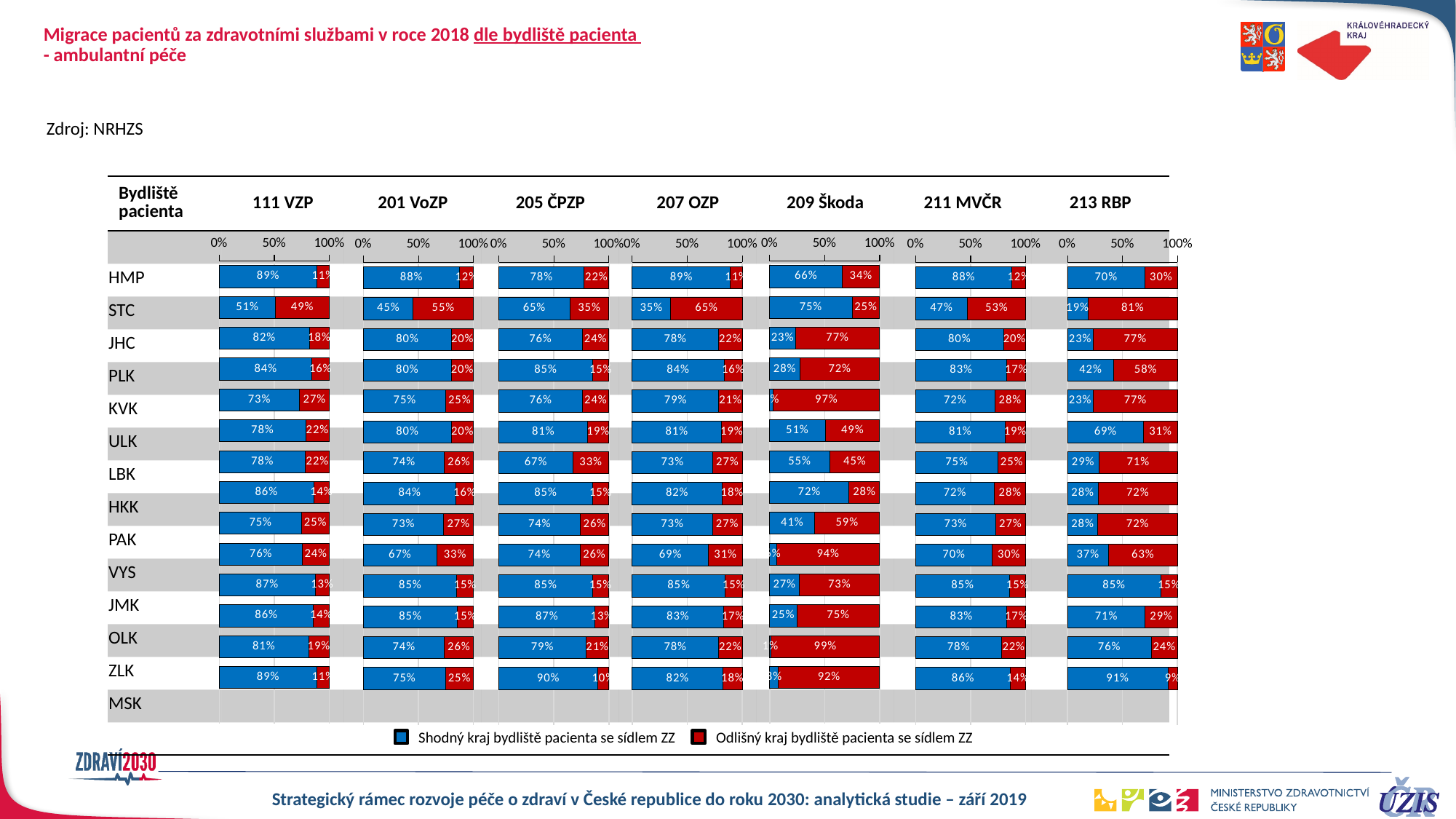
In the 111 VZP chart, what is the blue (Shodný kraj) share for HMP? 89% How many insurer charts (columns) are shown on the slide? 7 In the 213 RBP chart, what is the blue (Shodný kraj) share for STC? 19% How many series does the legend at the bottom of the slide list? 2 In the 111 VZP chart, which region has the lowest blue (Shodný kraj) share? STC What kind of chart is used for each insurer column on the slide? Stacked bar chart In the 111 VZP chart, what is the difference between the blue share for HMP and the blue share for STC? 38 percentage points In the 209 Škoda chart, what is the red (Odlišný kraj) share for STC? 25% In the 213 RBP chart, is the blue (Shodný kraj) share for JHC greater or less than 50%? less In the 209 Škoda chart, which region has the highest blue (Shodný kraj) share? STC For HMP, is the blue (Shodný kraj) share larger in the 205 ČPZP chart or the 207 OZP chart? 207 OZP In the 201 VoZP chart, what is the blue (Shodný kraj) share for KVK? 75%